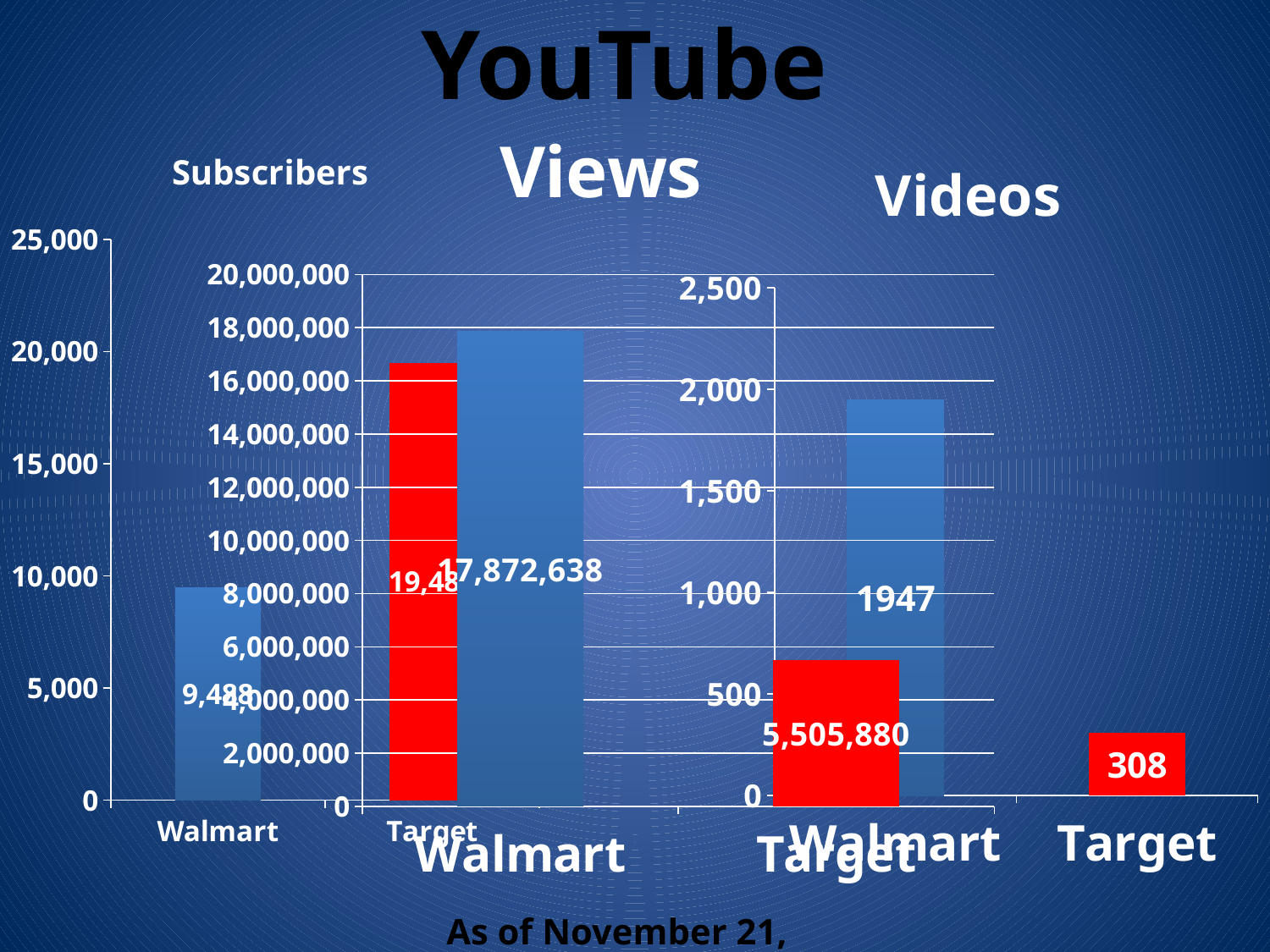
In the Views chart, what is the value for Target? 5,505,880 In the Videos chart, which category has the highest value? Walmart In the Videos chart, what is the value for Walmart? 1947 How many charts are shown on the slide? 3 In the Views chart, what is the value for Walmart? 17,872,638 In the Subscribers chart, what is the value for Walmart? 9,488 In the Views chart, what is the difference between the Walmart and Target values? 12,366,758 In the Videos chart, what is the difference between the Walmart and Target values? 1639 In the Subscribers chart, is the value for Target greater or less than 15,000? greater In the Videos chart, what is the value for Target? 308 What kind of chart is the Views chart? bar chart In the Views chart, which category has the lowest value? Target